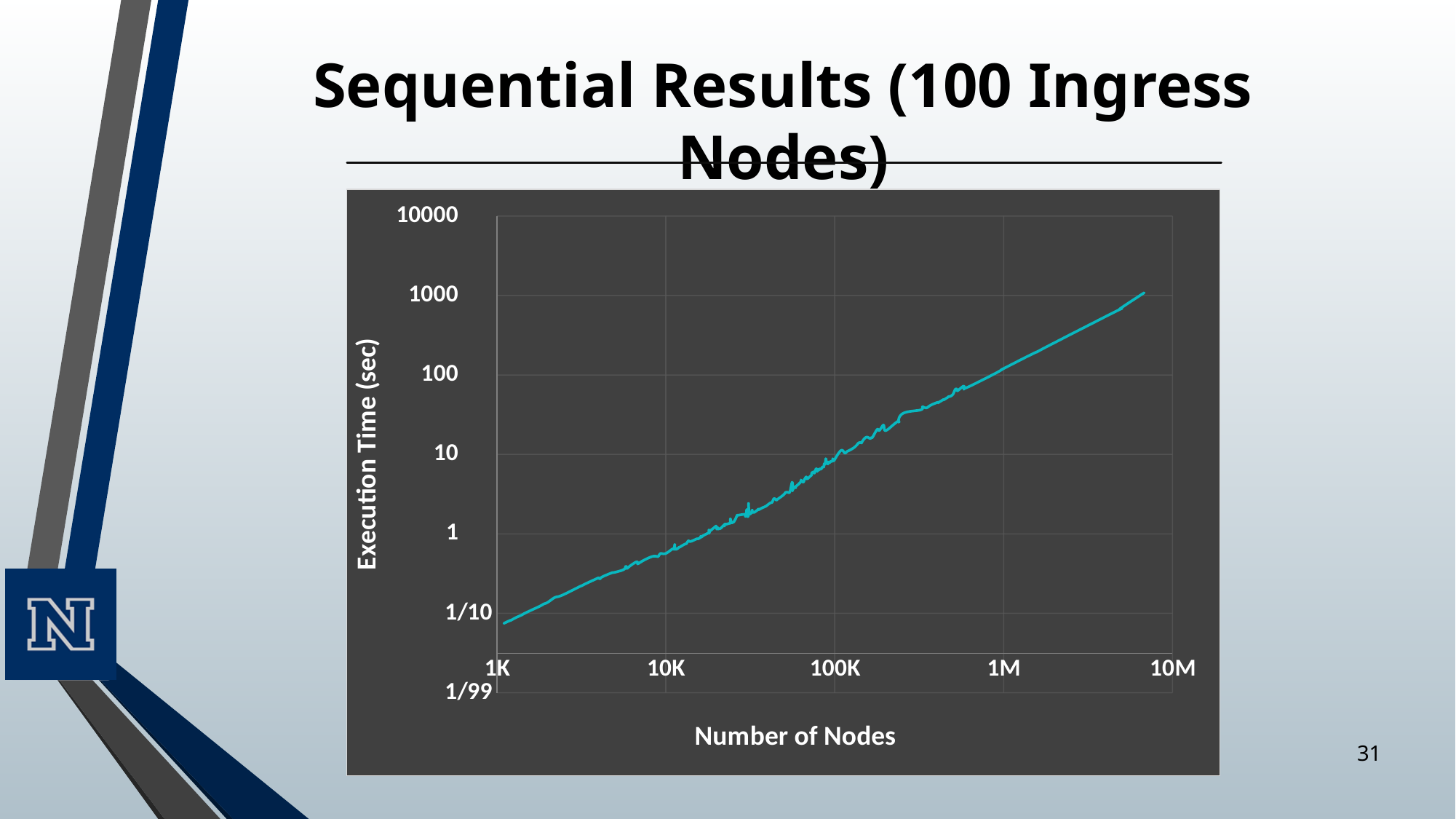
Which has the higher execution time, 1K nodes or 1M nodes? 1M nodes How many lines are plotted on the chart? 1 What kind of chart is shown on the slide? line chart Is the execution time at 10K nodes greater or less than 1/10 second? greater Is the execution time at 100K nodes greater or less than 1 second? greater How many labelled tick marks are on the x axis? 5 What is the label of the y axis? Execution Time (sec) Does execution time rise or fall as the number of nodes increases? rise Is the execution time at 10K nodes greater or less than 1 second? less What is the title of the chart? Sequential Results (100 Ingress Nodes)